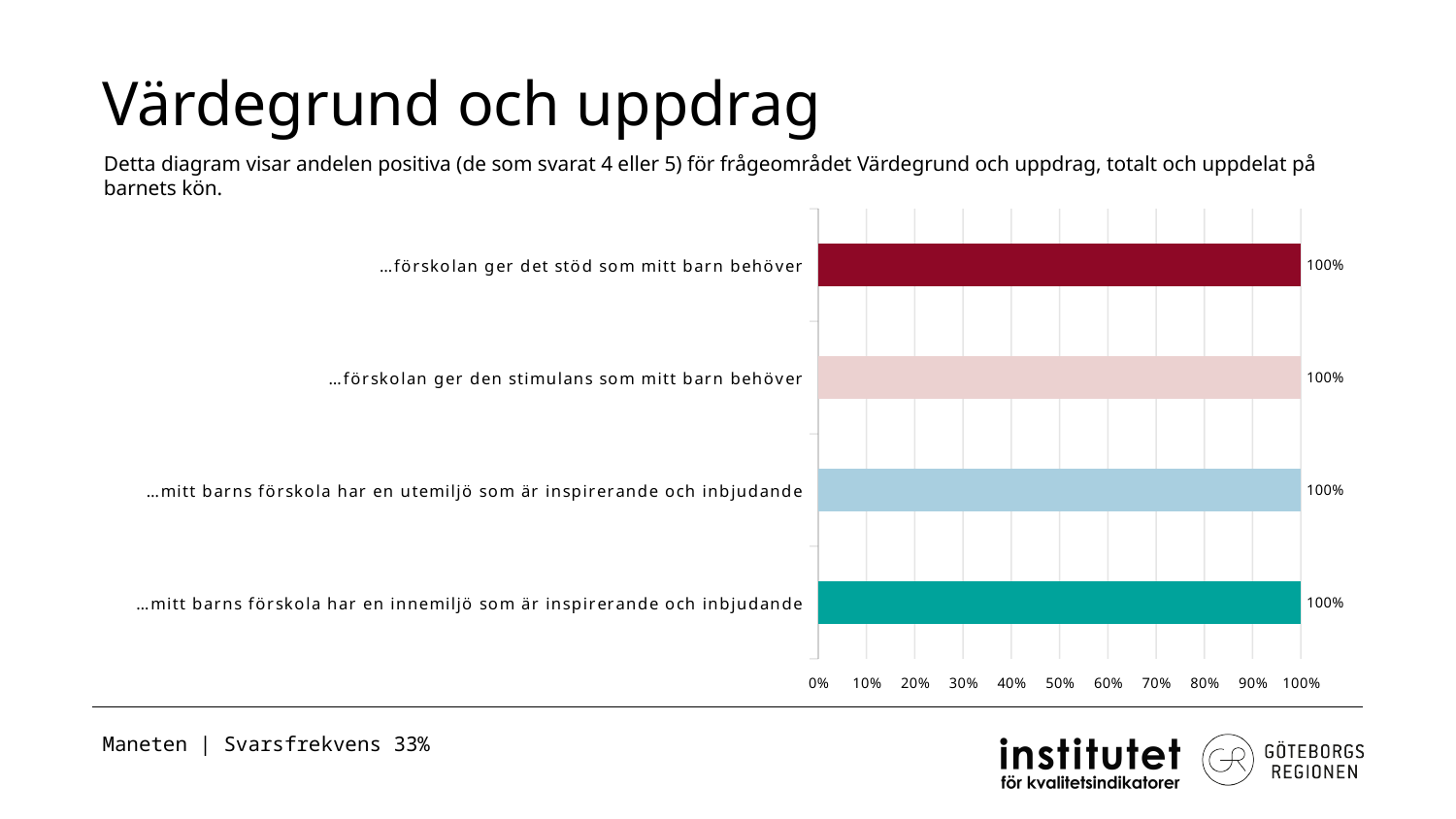
What value is shown for "…mitt barns förskola har en innemiljö som är inspirerande och inbjudande"? 100% What is the title of the slide containing the chart? Värdegrund och uppdrag What colour is the bar for "…mitt barns förskola har en innemiljö som är inspirerande och inbjudande"? teal Is the value for "…förskolan ger den stimulans som mitt barn behöver" greater or less than 50%? greater How many categories are shown in the chart? 4 What value is shown for "…mitt barns förskola har en utemiljö som är inspirerande och inbjudande"? 100% What is the difference between the value for "…förskolan ger det stöd som mitt barn behöver" and the value for "…mitt barns förskola har en innemiljö som är inspirerande och inbjudande"? 0% What is the highest value shown on the x axis of the chart? 100% What value is shown for "…förskolan ger det stöd som mitt barn behöver"? 100% What value is shown for "…förskolan ger den stimulans som mitt barn behöver"? 100% Is the value for "…mitt barns förskola har en utemiljö som är inspirerande och inbjudande" greater or less than 90%? greater What kind of chart is shown on the slide? bar chart